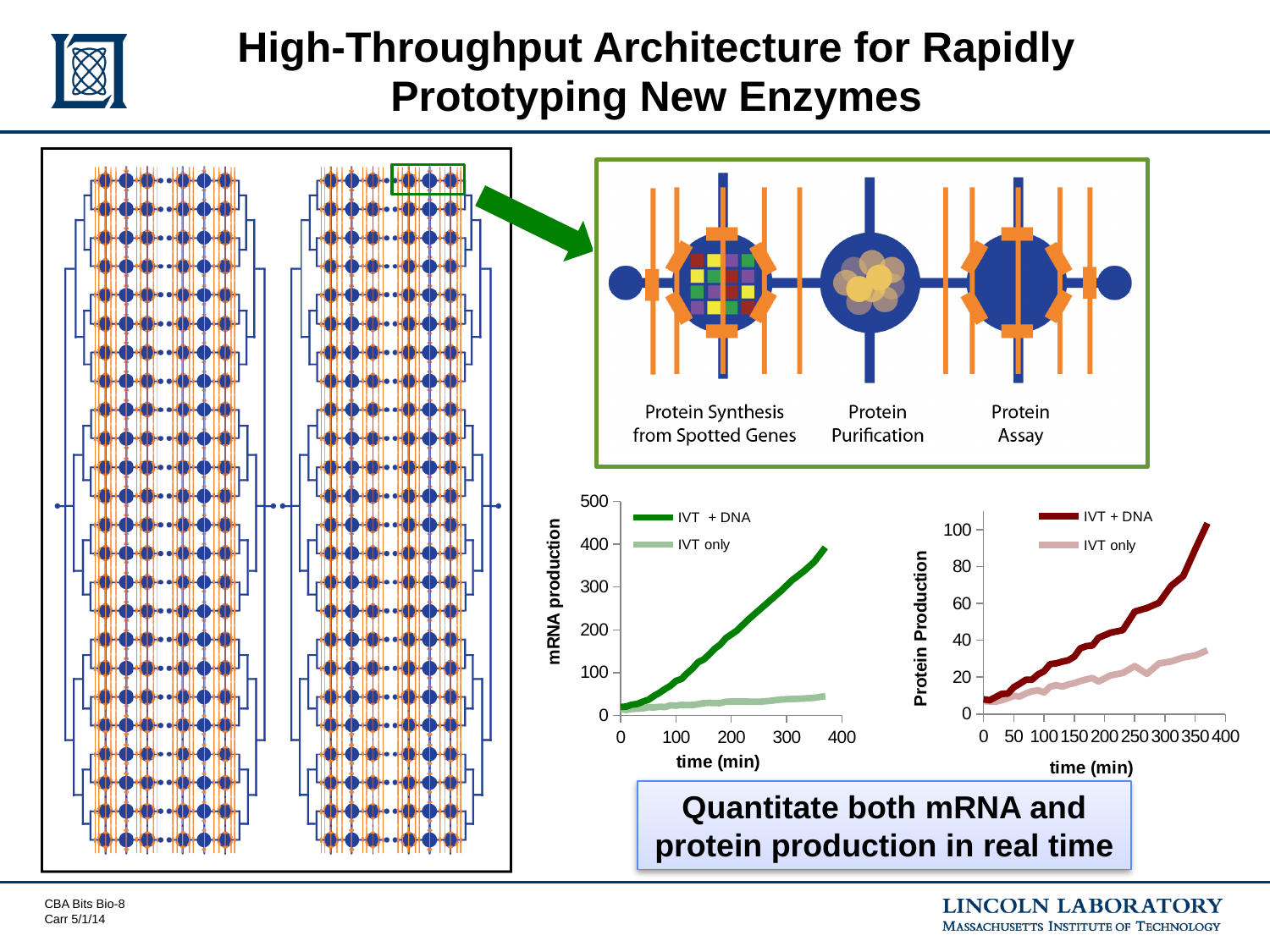
In the mRNA production chart, is the IVT only value at 300 min greater or less than 100? less In the Protein Production chart, does the IVT + DNA series rise or fall as time increases? rise In the Protein Production chart, is the IVT only value at 350 min greater or less than 60? less How many series does the legend of the Protein Production chart list? 2 What is the x-axis label of the Protein Production chart? time (min) What kind of chart is the mRNA production chart? line chart In the mRNA production chart, is the IVT + DNA value at 300 min greater or less than 200? greater What kind of chart is the Protein Production chart? line chart In the Protein Production chart, which series is lower at 350 min, IVT + DNA or IVT only? IVT only In the mRNA production chart, does the IVT + DNA series rise or fall as time increases? rise In the mRNA production chart, which series reaches the higher value at the end of the time range, IVT + DNA or IVT only? IVT + DNA How many series does the legend of the mRNA production chart list? 2